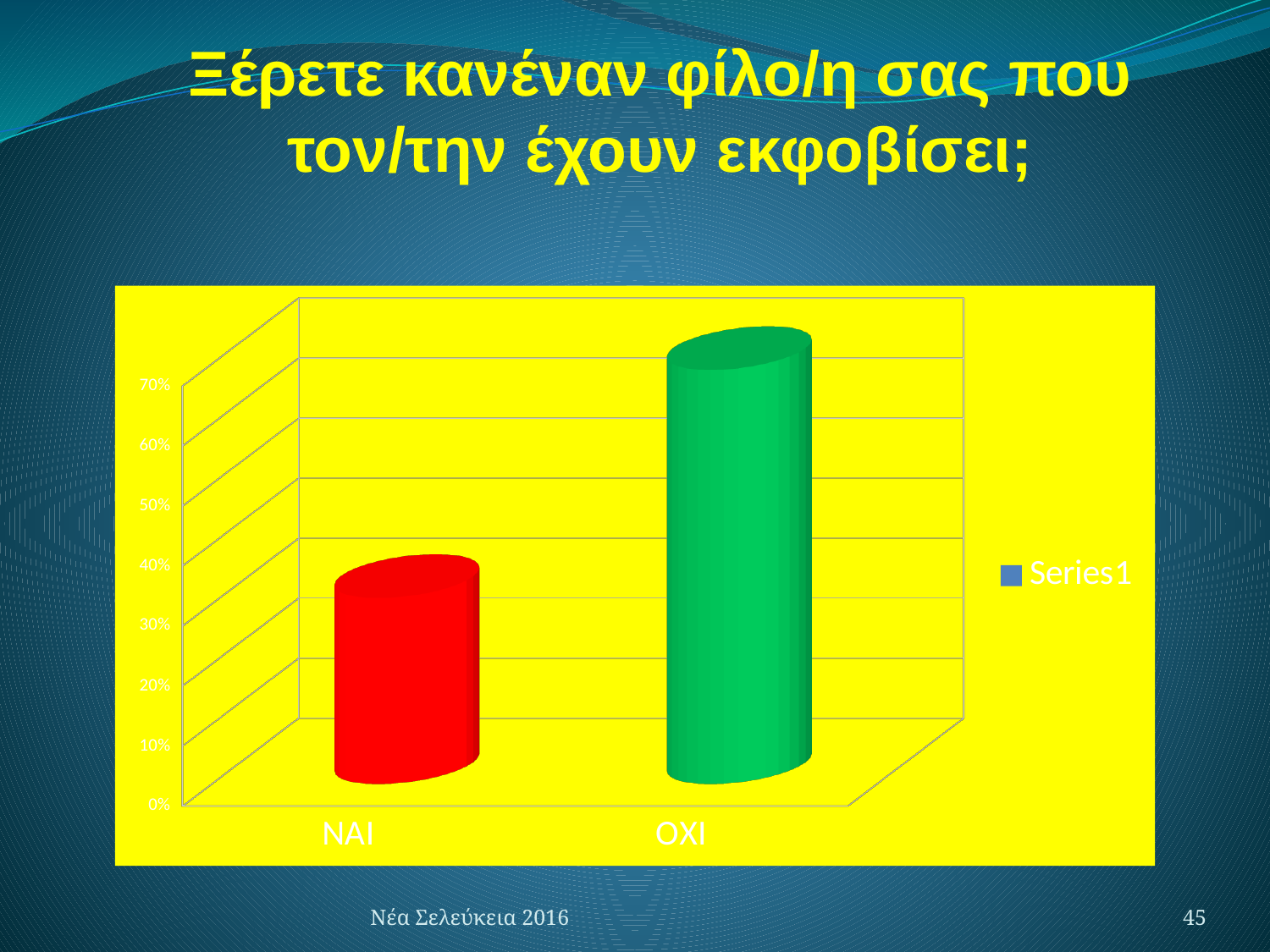
Is the value for ΟΧΙ greater or less than 50%? greater Which category has the highest bar in the chart? ΟΧΙ What colour is the bar for ΟΧΙ? green Which category has the lowest bar in the chart? ΝΑΙ What is the highest value shown on the vertical axis of the chart? 70% What kind of chart is shown on the slide? bar chart How many series does the chart legend list? 1 What is the name of the series shown in the chart legend? Series1 Is the value for ΝΑΙ greater or less than 20%? greater Which bar is taller, ΝΑΙ or ΟΧΙ? ΟΧΙ How many categories are shown on the x axis of the chart? 2 Is the value for ΝΑΙ greater or less than 50%? less